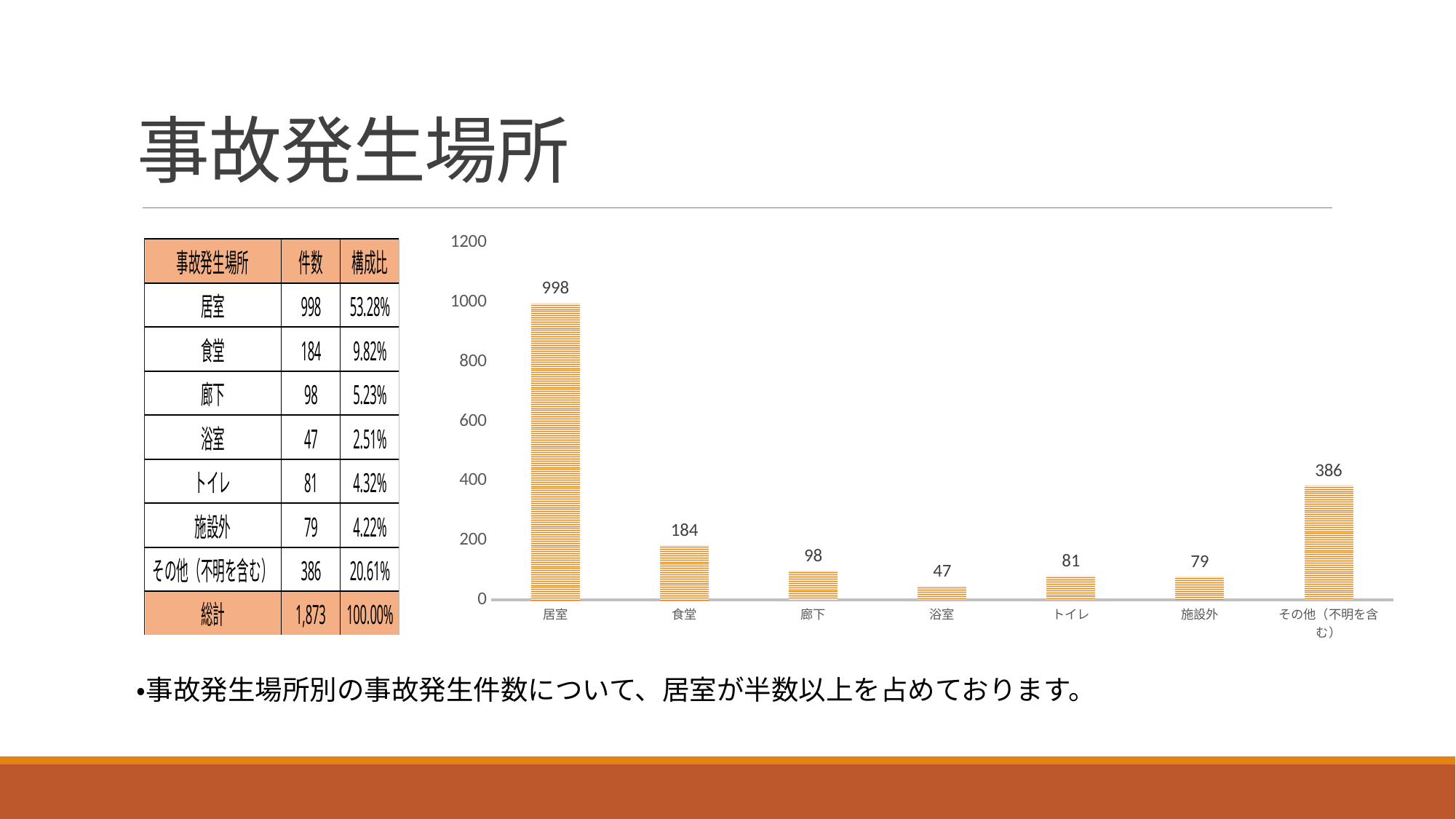
Which category has the highest value in the chart? 居室 What is the difference between the values for 食堂 and 廊下? 86 What is the value for 食堂 in the chart? 184 What is the difference between the values for 居室 and その他（不明を含む）? 612 What is the value for 居室 in the chart? 998 What is the value for 浴室 in the chart? 47 What kind of chart is shown on the slide? bar chart What is the value for その他（不明を含む） in the chart? 386 Is the value for 食堂 greater or less than 200? less Which is larger, the value for トイレ or the value for 施設外? トイレ Which category has the lowest value in the chart? 浴室 How many categories are shown on the x axis of the chart? 7